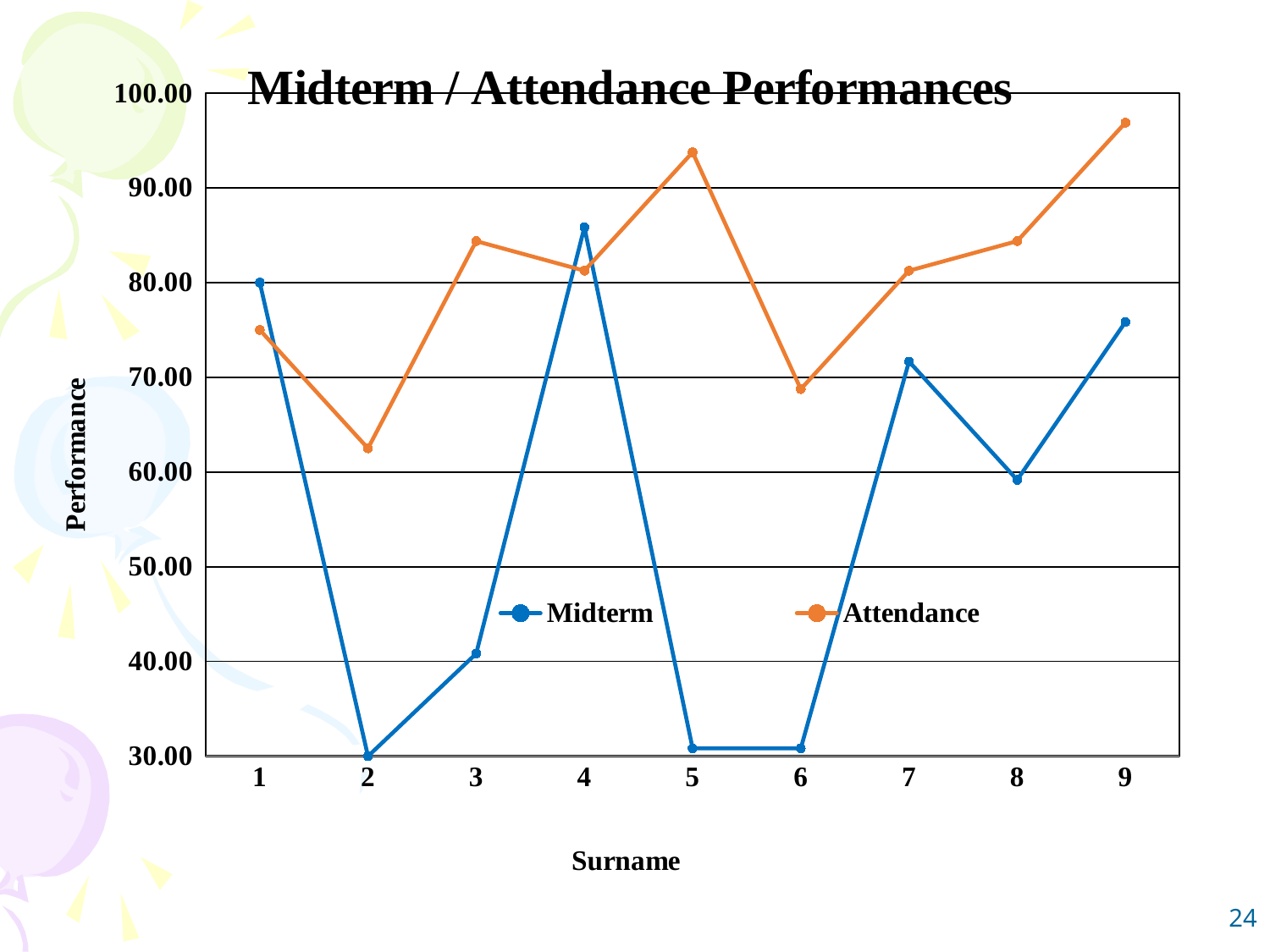
At which x-axis category is the Attendance value highest? 9 At which x-axis category is the Attendance value lowest? 2 What is the title of the x axis? Surname How many series does the legend list? 2 What kind of chart is shown on the slide? line chart At which x-axis category is the Midterm value highest? 4 Is the Midterm value at category 9 greater or less than 70.00? greater At category 4, which series has the larger value, Midterm or Attendance? Midterm At category 5, which series has the larger value, Midterm or Attendance? Attendance Is the Attendance value at category 5 greater or less than 90.00? greater Does the Attendance series rise or fall from category 6 to category 9? rise How many points are plotted along the x axis for each series? 9